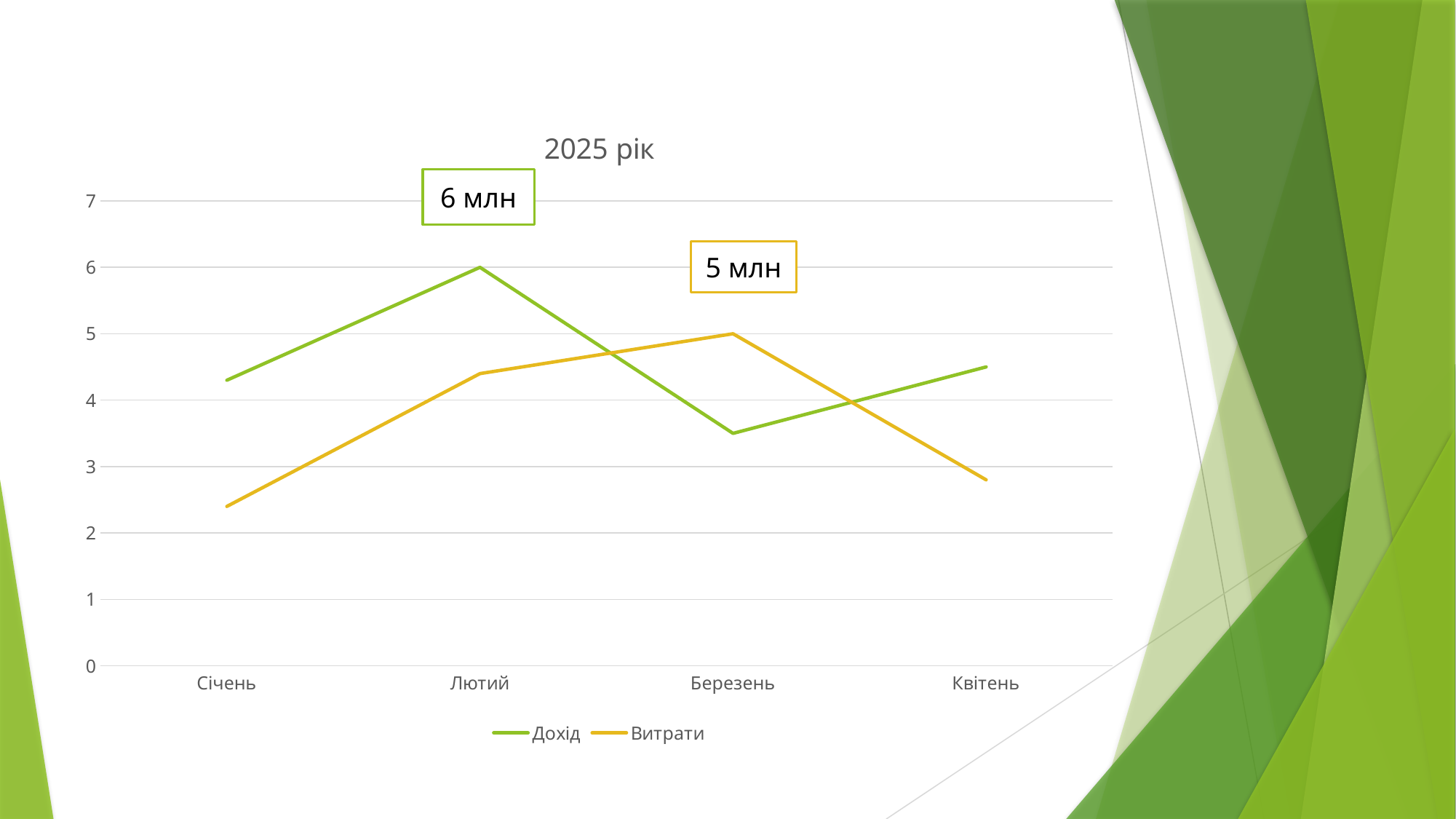
What kind of chart is shown on the slide? line chart What is the value of Витрати in Березень? 5 млн What is the title of the chart? 2025 рік In which month is Витрати highest? Березень Does Витрати rise or fall from Березень to Квітень? fall How many series does the legend list? 2 Is the value for Витрати in Січень greater or less than 3? less In Березень, which is larger: Дохід or Витрати? Витрати What is the value of Дохід in Лютий? 6 млн In which month is Дохід lowest? Березень In which month is Дохід highest? Лютий How many months are shown on the x axis? 4